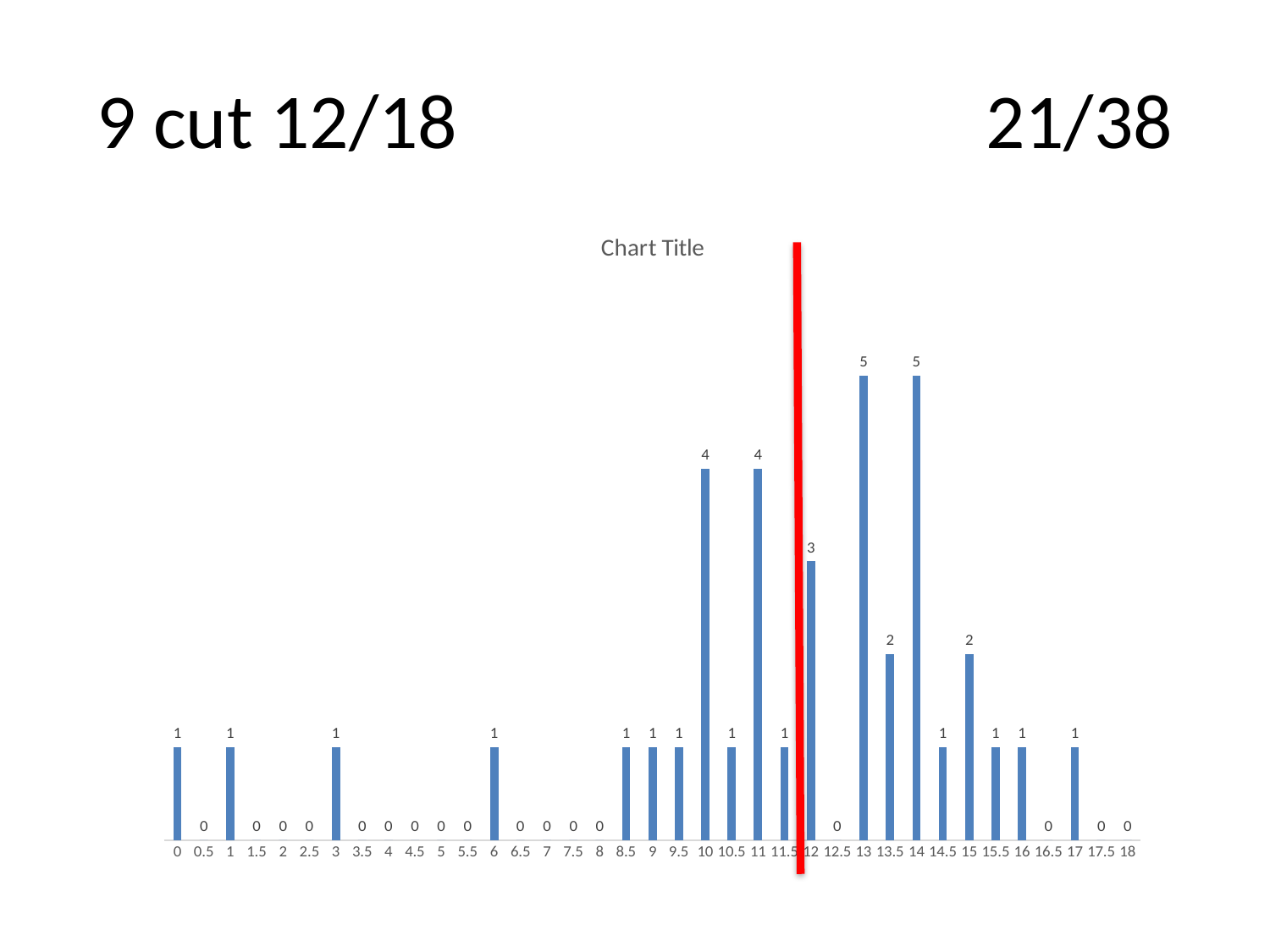
What is the value for category 12? 3 What is the value for category 10? 4 Which two categories share the highest value? 13 and 14 What is the value for category 13.5? 2 How many categories are shown on the x axis? 37 What is the highest value shown in the chart? 5 What is the difference between the values for categories 11 and 15? 2 What is the value for category 6? 1 What kind of chart is shown on the slide? bar chart Which has the larger value, category 10 or category 12? 10 What is the title of the chart? Chart Title What is the difference between the values for categories 13 and 12? 2